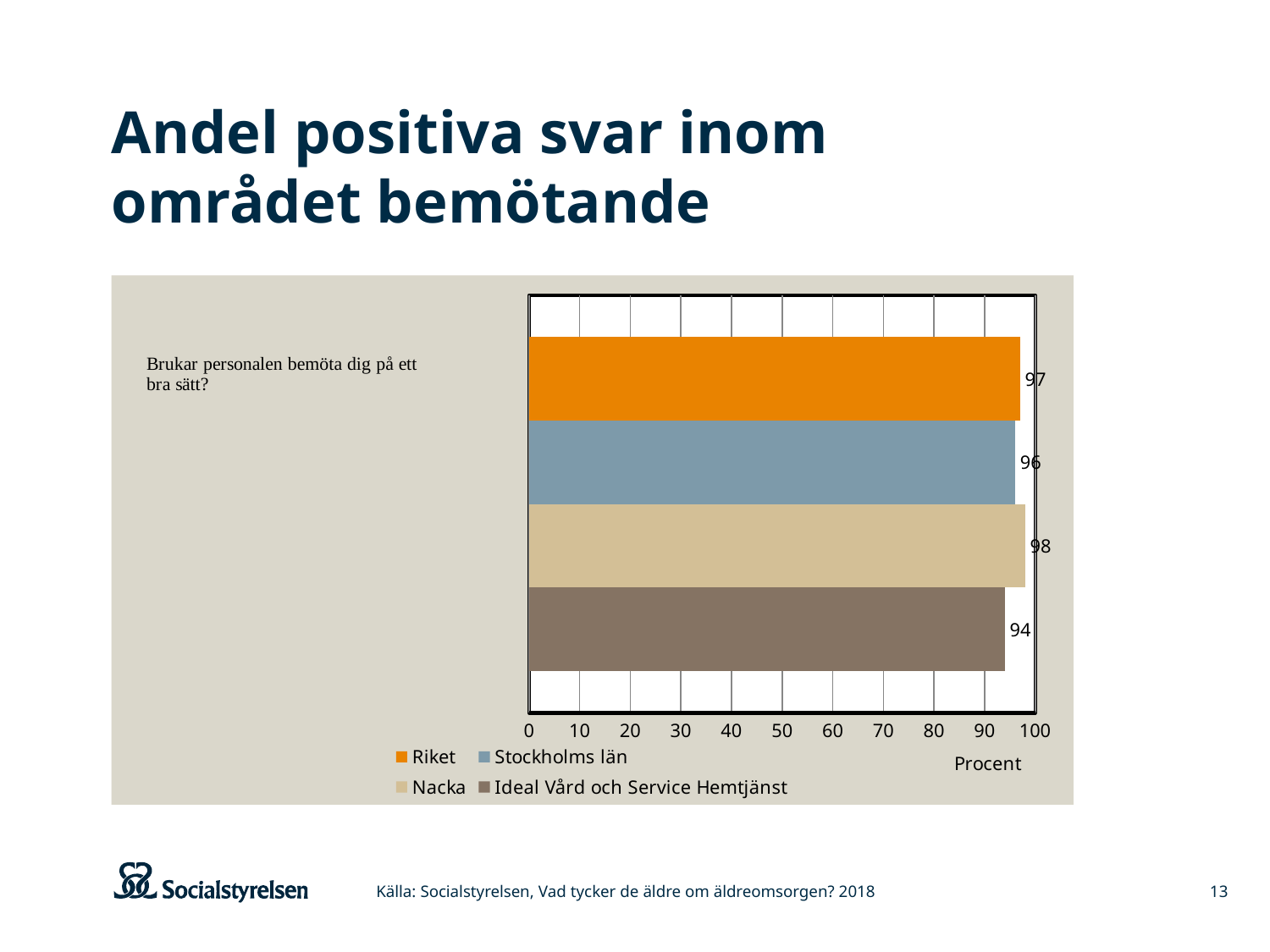
What is the difference between the values for Nacka and Ideal Vård och Service Hemtjänst? 4 What is the value for Nacka? 98 Which is larger, the value for Riket or the value for Ideal Vård och Service Hemtjänst? Riket Which series has the lowest value? Ideal Vård och Service Hemtjänst How many series does the legend list? 4 What is the value for Stockholms län? 96 What is the value for Ideal Vård och Service Hemtjänst? 94 What unit is shown on the x axis of the chart? Procent Which series has the highest value? Nacka What is the value for Riket? 97 Is the value for Ideal Vård och Service Hemtjänst greater or less than 90? greater What kind of chart is shown on the slide? bar chart